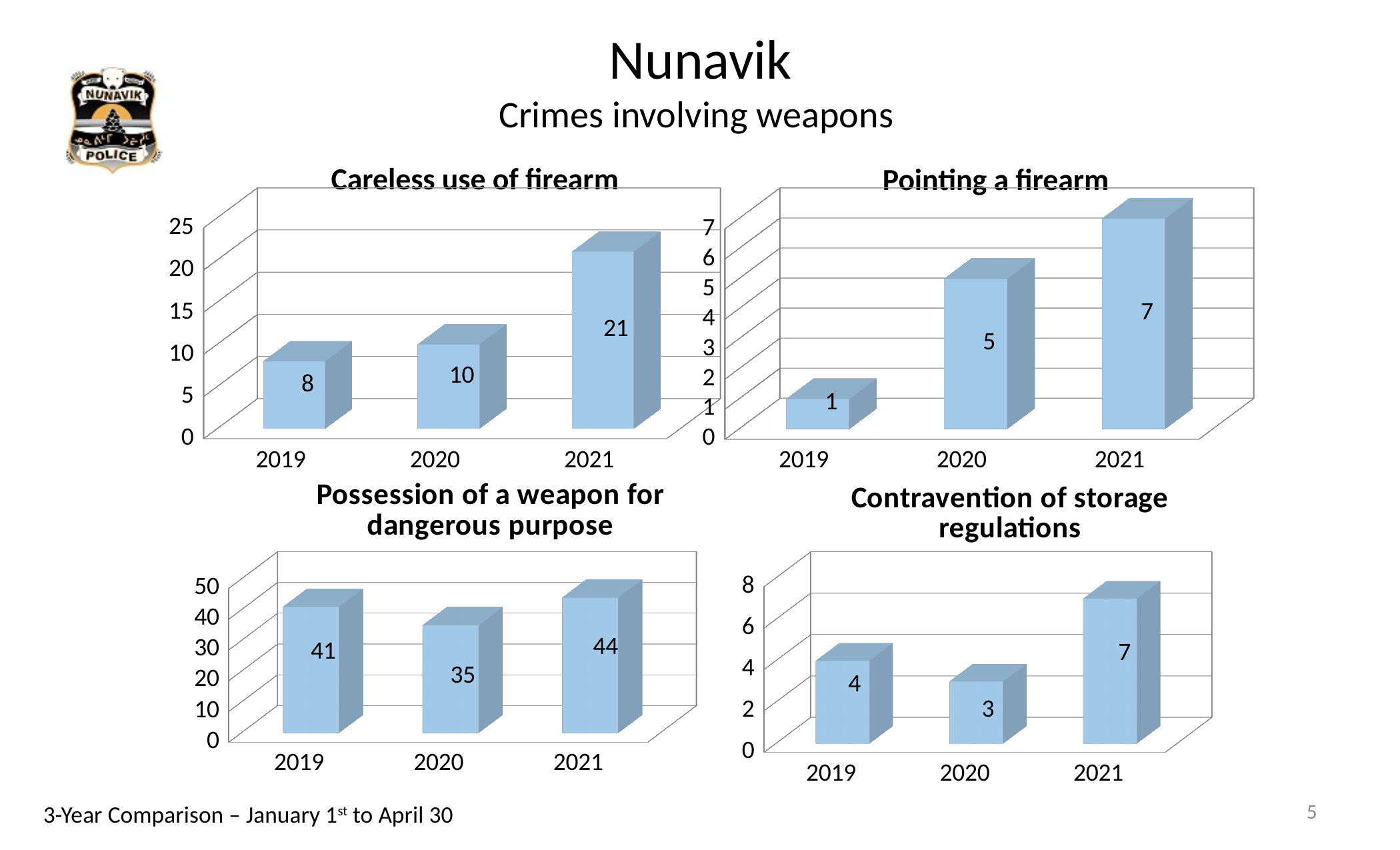
In the 'Pointing a firearm' chart, what is the value for 2019? 1 In the 'Possession of a weapon for dangerous purpose' chart, which year has the lowest value? 2020 How many years are shown on the x axis of the 'Careless use of firearm' chart? 3 In the 'Careless use of firearm' chart, what is the value for 2021? 21 In the 'Contravention of storage regulations' chart, which is larger, the value for 2019 or the value for 2020? 2019 In the 'Pointing a firearm' chart, what is the difference between the 2021 and 2020 values? 2 In the 'Pointing a firearm' chart, do the values rise or fall from 2019 to 2021? Rise In the 'Careless use of firearm' chart, what is the difference between the 2021 and 2019 values? 13 In the 'Contravention of storage regulations' chart, which year has the highest value? 2021 How many charts are shown on the slide? 4 What kind of chart is 'Pointing a firearm'? Bar chart In the 'Possession of a weapon for dangerous purpose' chart, what is the value for 2020? 35